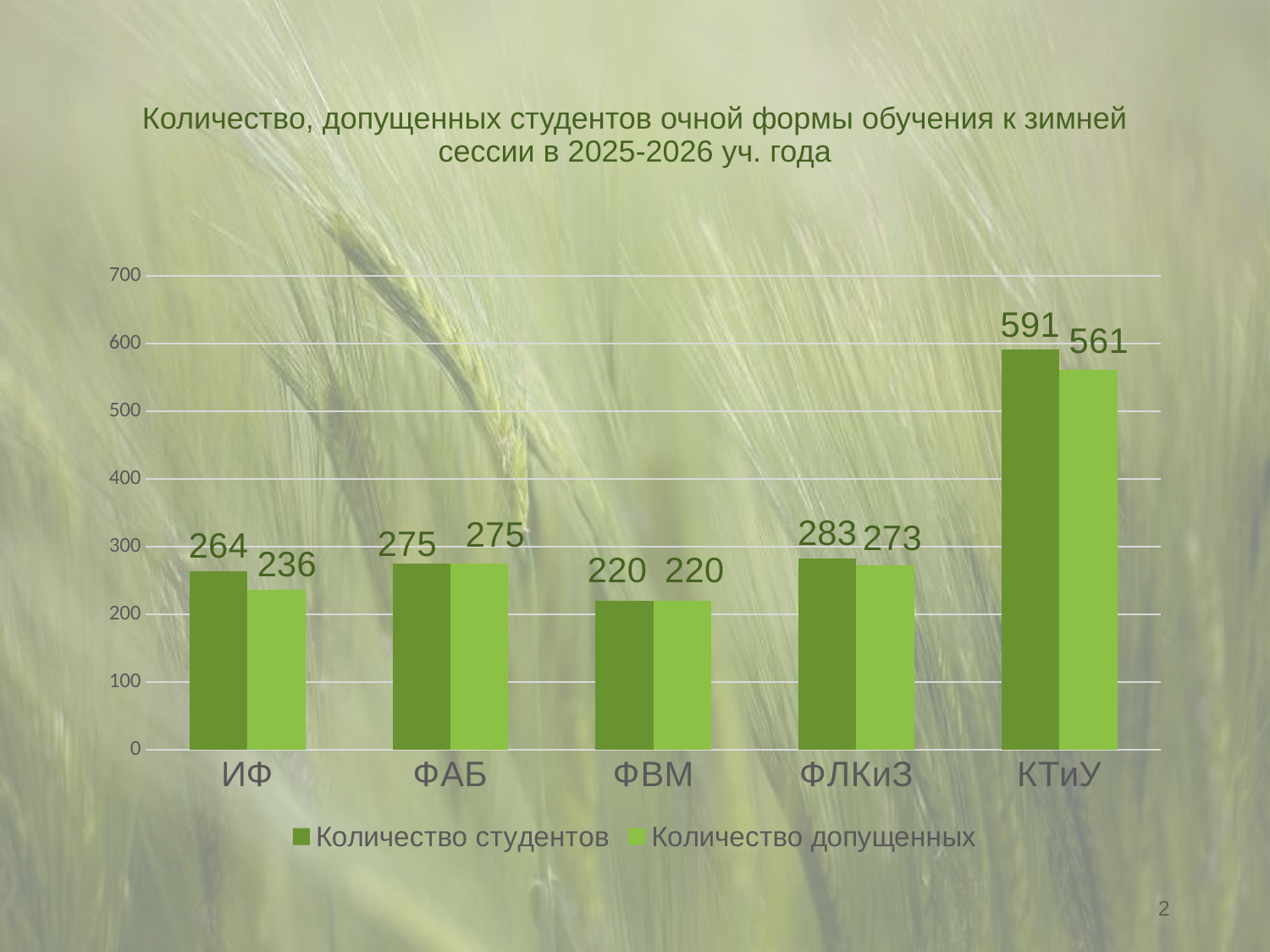
What is the value of "Количество студентов" for ИФ? 264 How many categories are shown on the x axis? 5 Which category has the lowest value for "Количество допущенных"? ФВМ What is the title of the chart? Количество, допущенных студентов очной формы обучения к зимней сессии в 2025-2026 уч. года Which category has the highest value for "Количество студентов"? КТиУ What kind of chart is shown on the slide? bar chart What is the difference between "Количество студентов" and "Количество допущенных" for ИФ? 28 What is the difference between "Количество студентов" and "Количество допущенных" for КТиУ? 30 What is the value of "Количество допущенных" for ФЛКиЗ? 273 Which is larger: "Количество студентов" for ФЛКиЗ or "Количество студентов" for ФАБ? ФЛКиЗ How many series does the legend list? 2 What is the value of "Количество допущенных" for КТиУ? 561